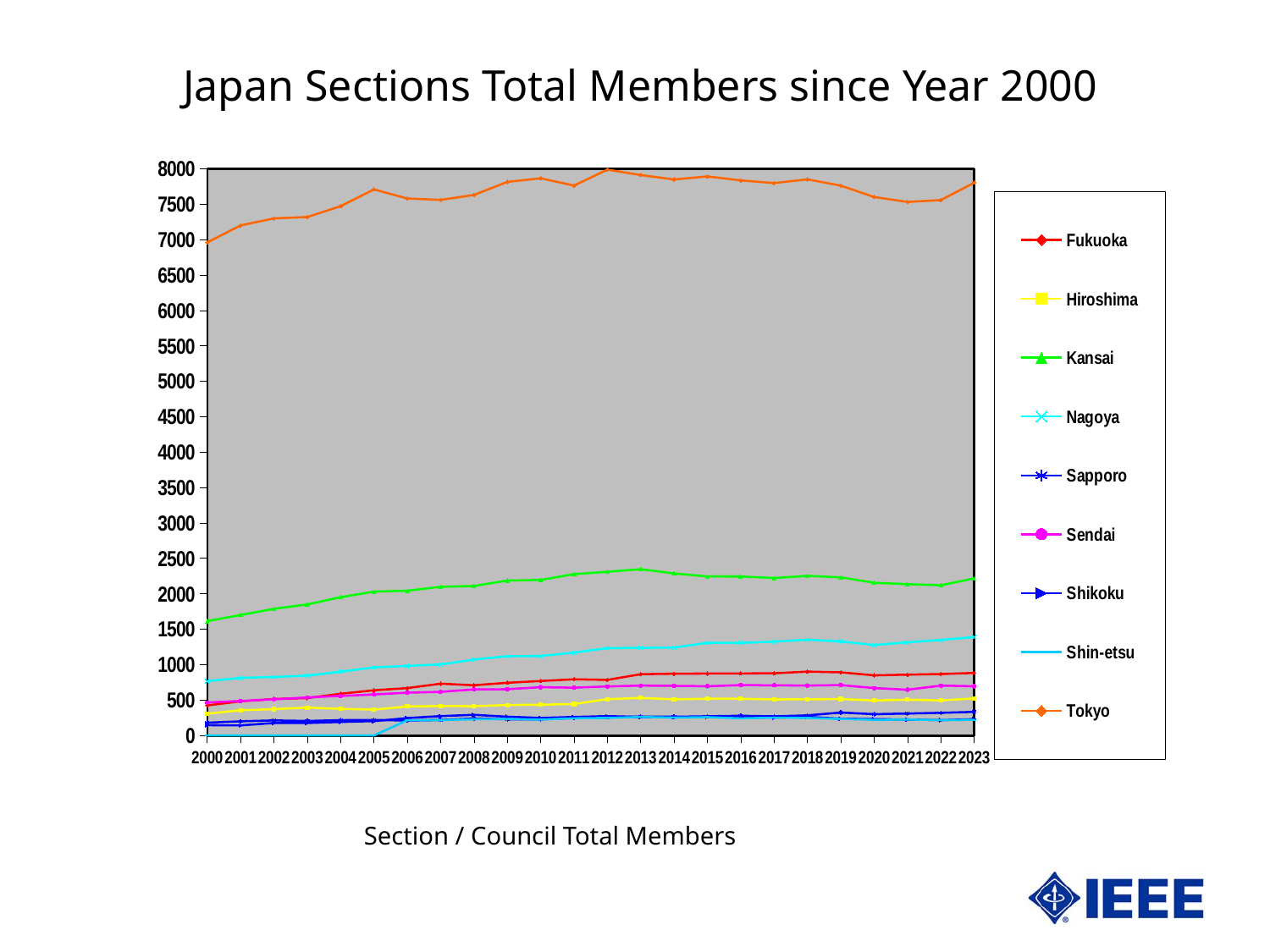
Is the value for Tokyo in 2005 greater or less than 7500? greater Does the Nagoya line rise or fall from 2000 to 2023? rise What is the title of the chart? Japan Sections Total Members since Year 2000 Is the value for Hiroshima in 2000 greater or less than 500? less How many series does the legend list? 9 How many years are plotted along the x axis? 24 Is the value for Kansai in 2013 greater or less than 2000? greater Which section has the lowest total members in 2000? Shin-etsu Which is larger in 2023, the value for Kansai or the value for Nagoya? Kansai What kind of chart is shown on the slide? line chart Which section has the highest total members throughout the chart? Tokyo